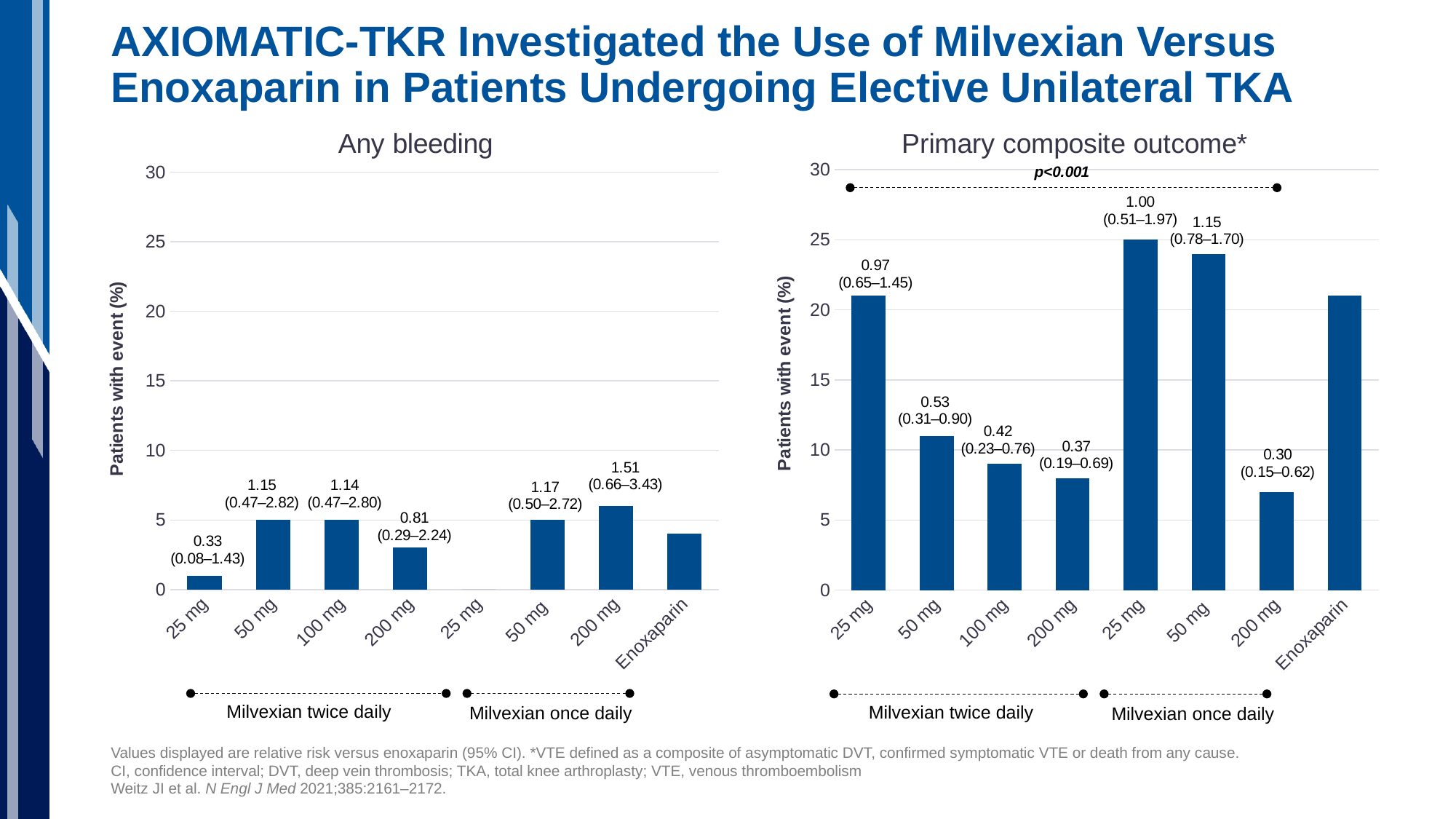
What p-value is printed on the 'Primary composite outcome*' chart? p<0.001 In the 'Primary composite outcome*' chart, which is larger: the bar for 25 mg Milvexian twice daily or the bar for 50 mg Milvexian twice daily? 25 mg Milvexian twice daily In the 'Primary composite outcome*' chart, do the values rise or fall across the Milvexian twice daily doses from 25 mg to 200 mg? fall How many categories are shown on the x axis of the 'Any bleeding' chart? 8 What is the y-axis title of the 'Any bleeding' chart? Patients with event (%) In the 'Primary composite outcome*' chart, is the value for Enoxaparin greater or less than 15? greater In the 'Primary composite outcome*' chart, what relative risk label is printed above the 200 mg Milvexian once daily bar? 0.30 (0.15–0.62) In the 'Any bleeding' chart, what relative risk label is printed above the 200 mg Milvexian once daily bar? 1.51 (0.66–3.43) In the 'Primary composite outcome*' chart, how many bars are in the Milvexian once daily group? 3 What kind of chart is the 'Any bleeding' chart? bar chart In the 'Any bleeding' chart, which category has the lowest bar? 25 mg (Milvexian once daily) In the 'Any bleeding' chart, is the value for 25 mg Milvexian twice daily greater or less than 5? less